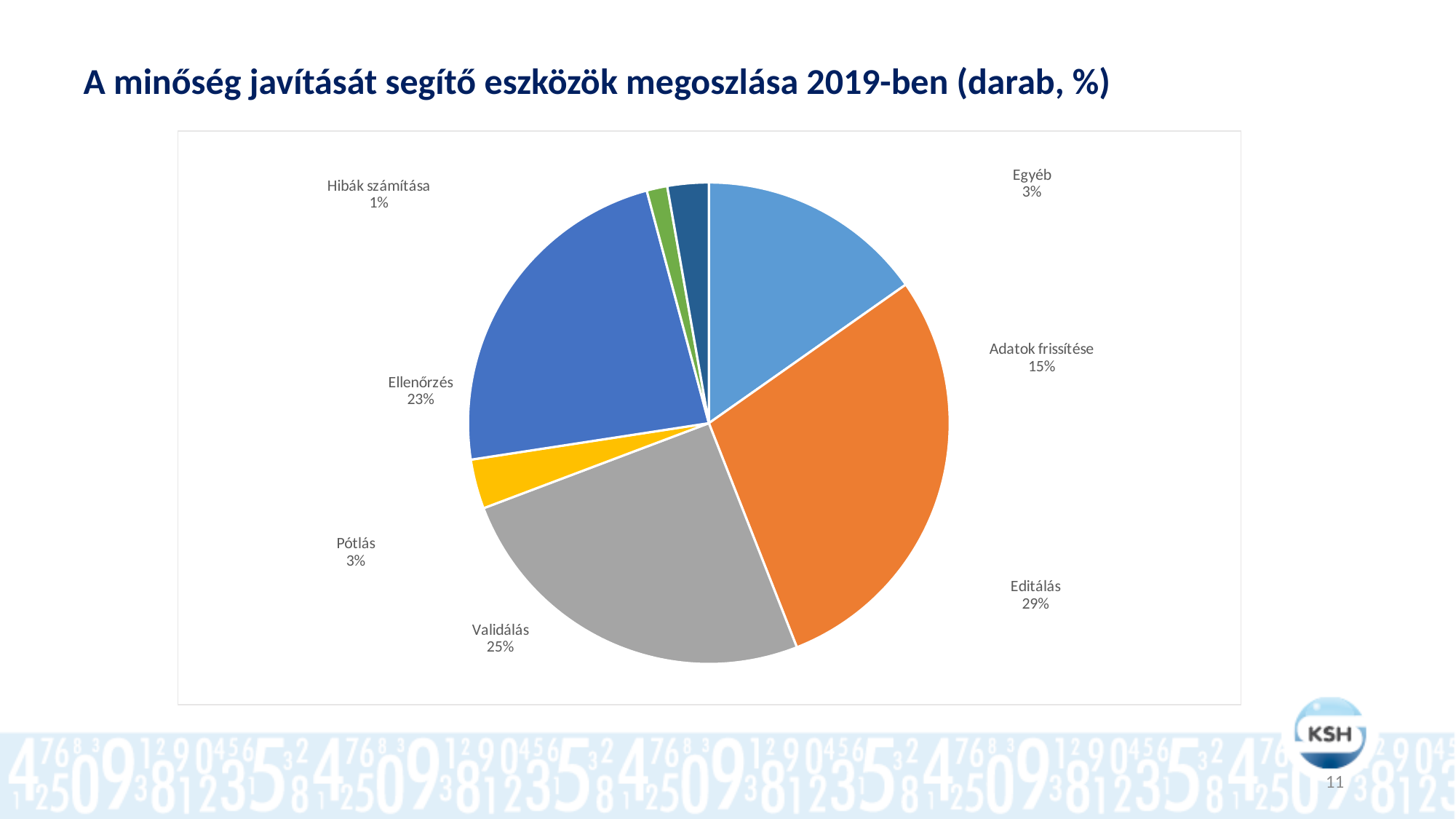
What is the difference in percentage points between Ellenőrzés and Adatok frissítése? 8 What is the value shown for Adatok frissítése? 15% Which category has the smallest share of the pie? Hibák számítása What is the difference in percentage points between Editálás and Validálás? 4 Which is larger, the share for Validálás or the share for Ellenőrzés? Validálás How many categories (slices) does the pie chart have? 7 Which category has the largest share of the pie? Editálás What share of the pie does Editálás have? 29% What is the value shown for Validálás? 25% What is the value shown for Ellenőrzés? 23% What kind of chart is shown on the slide? pie chart What is the title of the slide? A minőség javítását segítő eszközök megoszlása 2019-ben (darab, %)